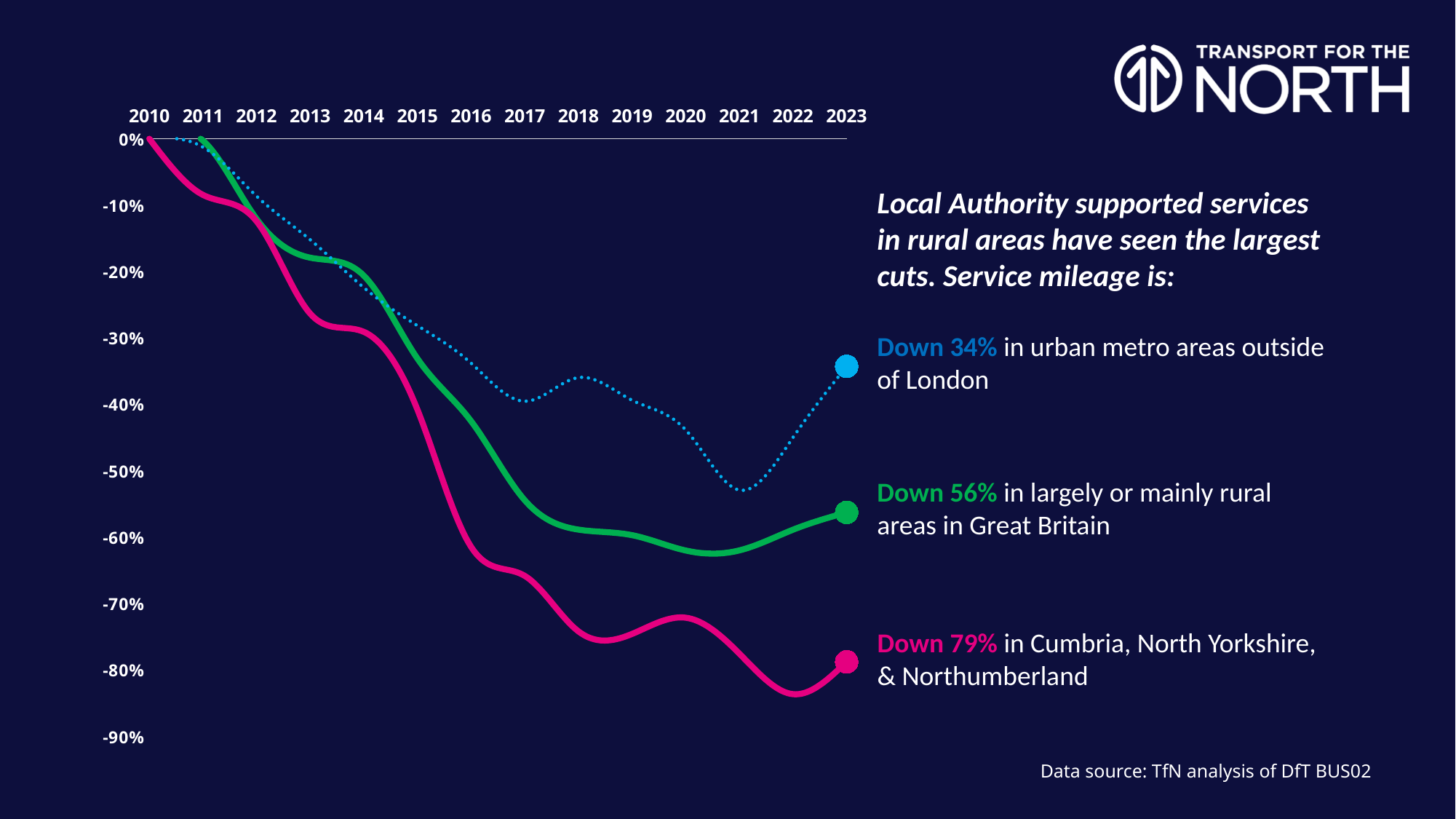
How many percentage points larger is the 2023 cut in Cumbria, North Yorkshire & Northumberland than in urban metro areas outside of London? 45 percentage points Which area has seen the largest cut in service mileage by 2023? Cumbria, North Yorkshire, & Northumberland How many years are shown along the x axis? 14 What kind of chart is shown on the slide? line chart By how much is service mileage down in Cumbria, North Yorkshire & Northumberland by 2023? Down 79% How many lines (series) are plotted on the chart? 3 By how much is service mileage down in urban metro areas outside of London by 2023? Down 34% Is the value for urban metro areas outside of London in 2021 greater or less than -50%? less What is the data source given on the slide? TfN analysis of DfT BUS02 Which area has seen the smallest cut in service mileage by 2023? urban metro areas outside of London Is the value for Cumbria, North Yorkshire & Northumberland in 2022 greater or less than -80%? less By how much is service mileage down in largely or mainly rural areas in Great Britain by 2023? Down 56%